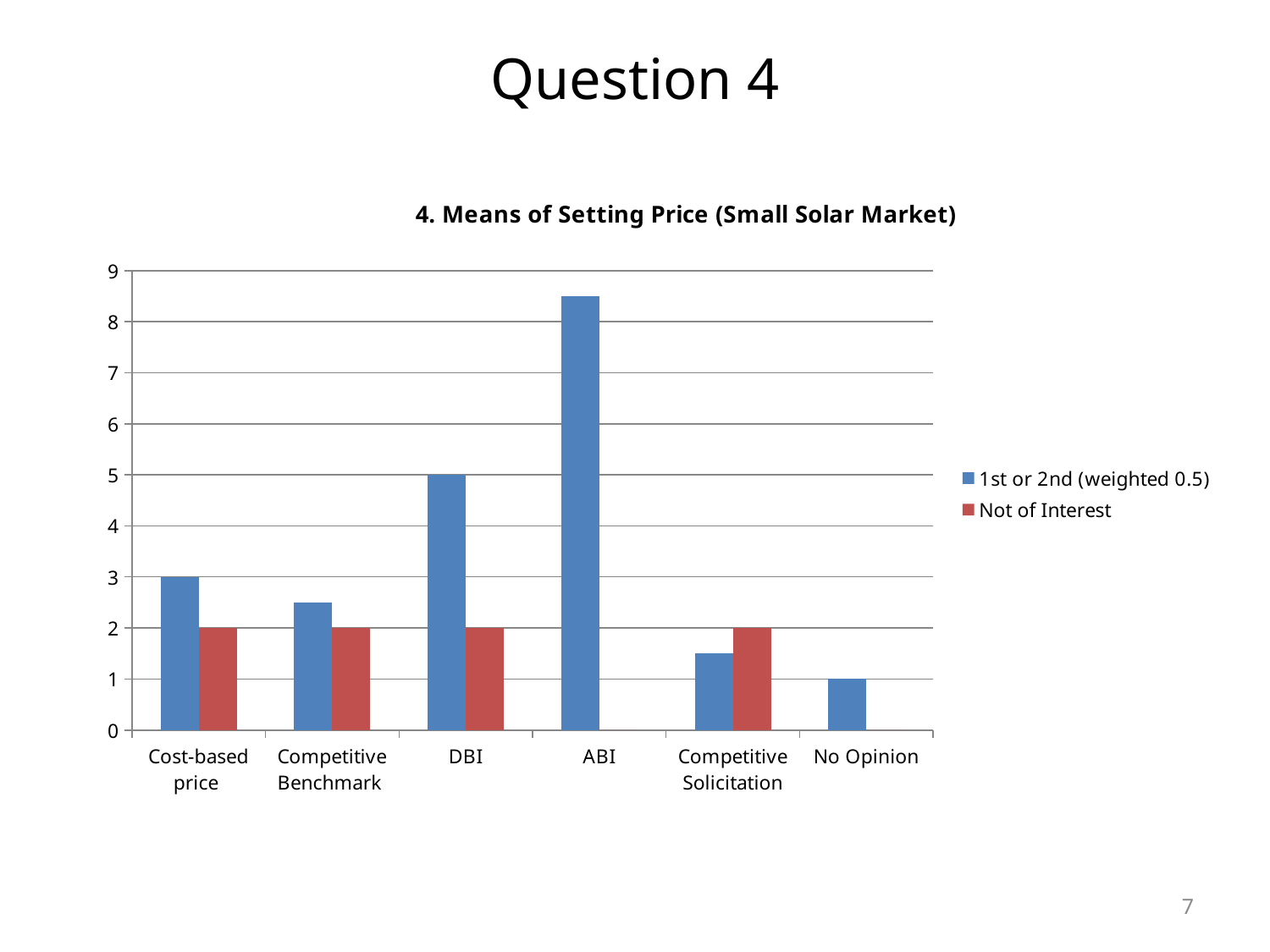
Which series is shown in red? Not of Interest What is the '1st or 2nd (weighted 0.5)' value for Cost-based price? 3 Which is larger for the '1st or 2nd (weighted 0.5)' series: DBI or Competitive Benchmark? DBI Is the '1st or 2nd (weighted 0.5)' value for Competitive Solicitation greater or less than 2? less How many categories are shown on the x axis? 6 Is the '1st or 2nd (weighted 0.5)' value for ABI greater or less than 8? greater Which category has the highest value for the '1st or 2nd (weighted 0.5)' series? ABI How many series does the legend list? 2 What is the title of the chart? 4. Means of Setting Price (Small Solar Market) Which category has the lowest value for the '1st or 2nd (weighted 0.5)' series? No Opinion What kind of chart is shown on the slide? Bar chart What is the '1st or 2nd (weighted 0.5)' value for DBI? 5